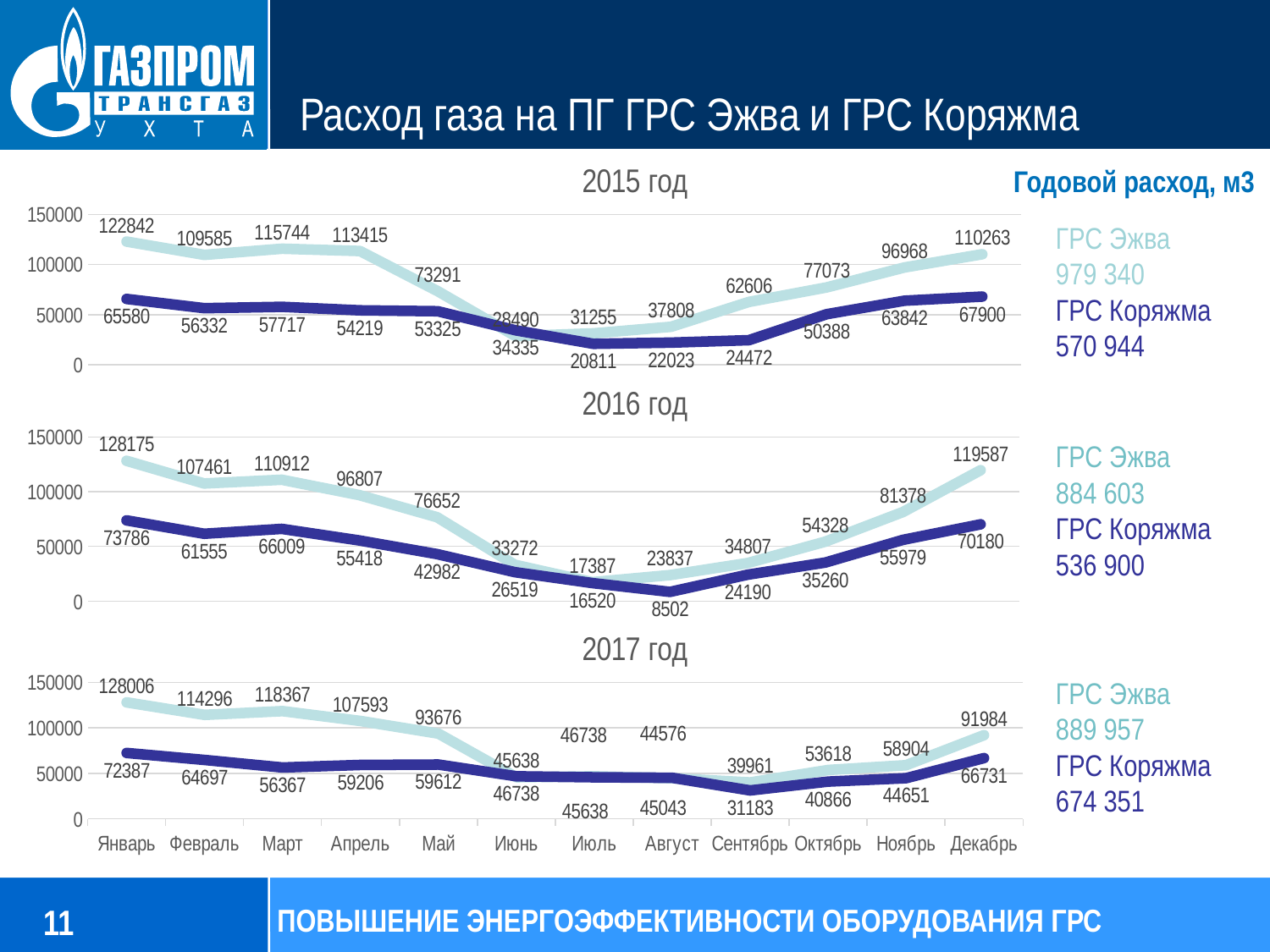
How many months are plotted on the x axis of each chart? 12 On the 2017 год chart, which is larger in Март: ГРС Эжва or ГРС Коряжма? ГРС Эжва On the 2016 год chart, what is the difference between ГРС Эжва and ГРС Коряжма in Декабрь? 49407 On the 2015 год chart, in which month is ГРС Коряжма lowest? Июль What annual consumption (Годовой расход, м3) is shown for ГРС Эжва in 2015? 979 340 On the 2015 год chart, what is the difference between ГРС Эжва and ГРС Коряжма in Январь? 57262 On the 2015 год chart, what is the value for ГРС Эжва in Январь? 122842 On the 2016 год chart, in which month is ГРС Эжва highest? Январь On the 2017 год chart, what is the value for ГРС Эжва in Декабрь? 91984 On the 2015 год chart, does ГРС Эжва rise or fall from Январь to Июнь? fall On the 2016 год chart, what is the value for ГРС Коряжма in Август? 8502 What type of chart is used for the 2016 год data? line chart